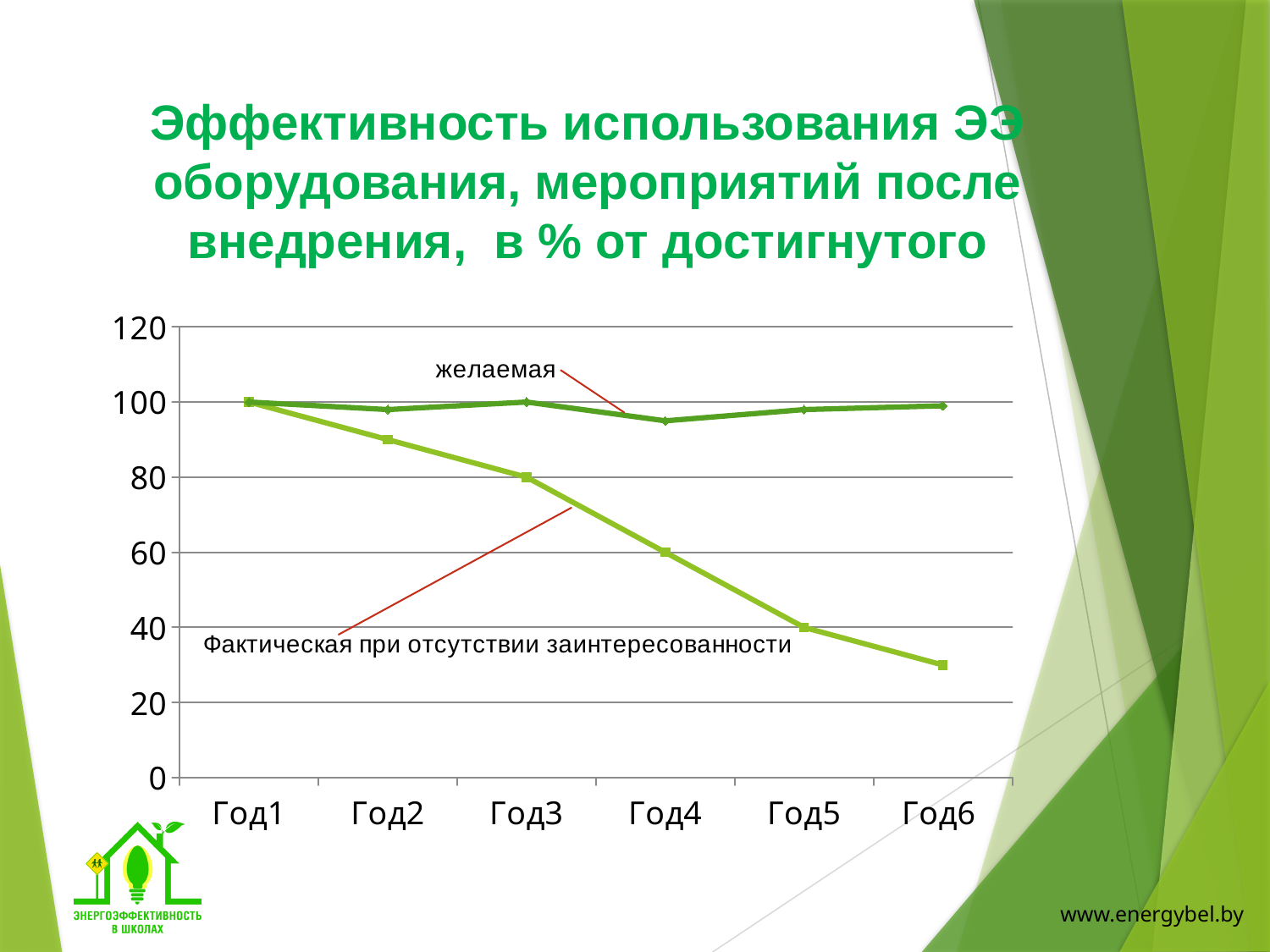
What is the label of the upper, nearly flat line on the chart? желаемая How many data series are plotted on the chart? 2 What is the value of the 'Фактическая при отсутствии заинтересованности' series at Год1? 100 Is the value of the 'желаемая' series at Год4 greater or less than 80? greater Is the value of the 'Фактическая при отсутствии заинтересованности' series at Год6 greater or less than 40? less Does the 'Фактическая при отсутствии заинтересованности' series rise or fall from Год1 to Год6? fall At Год5, which series has the higher value: 'желаемая' or 'Фактическая при отсутствии заинтересованности'? желаемая How many years (categories) are shown on the x axis? 6 What is the value of the 'Фактическая при отсутствии заинтересованности' series at Год4? 60 In which year is the 'Фактическая при отсутствии заинтересованности' series at its lowest? Год6 What is the value of the 'Фактическая при отсутствии заинтересованности' series at Год3? 80 What kind of chart is shown on the slide? line chart